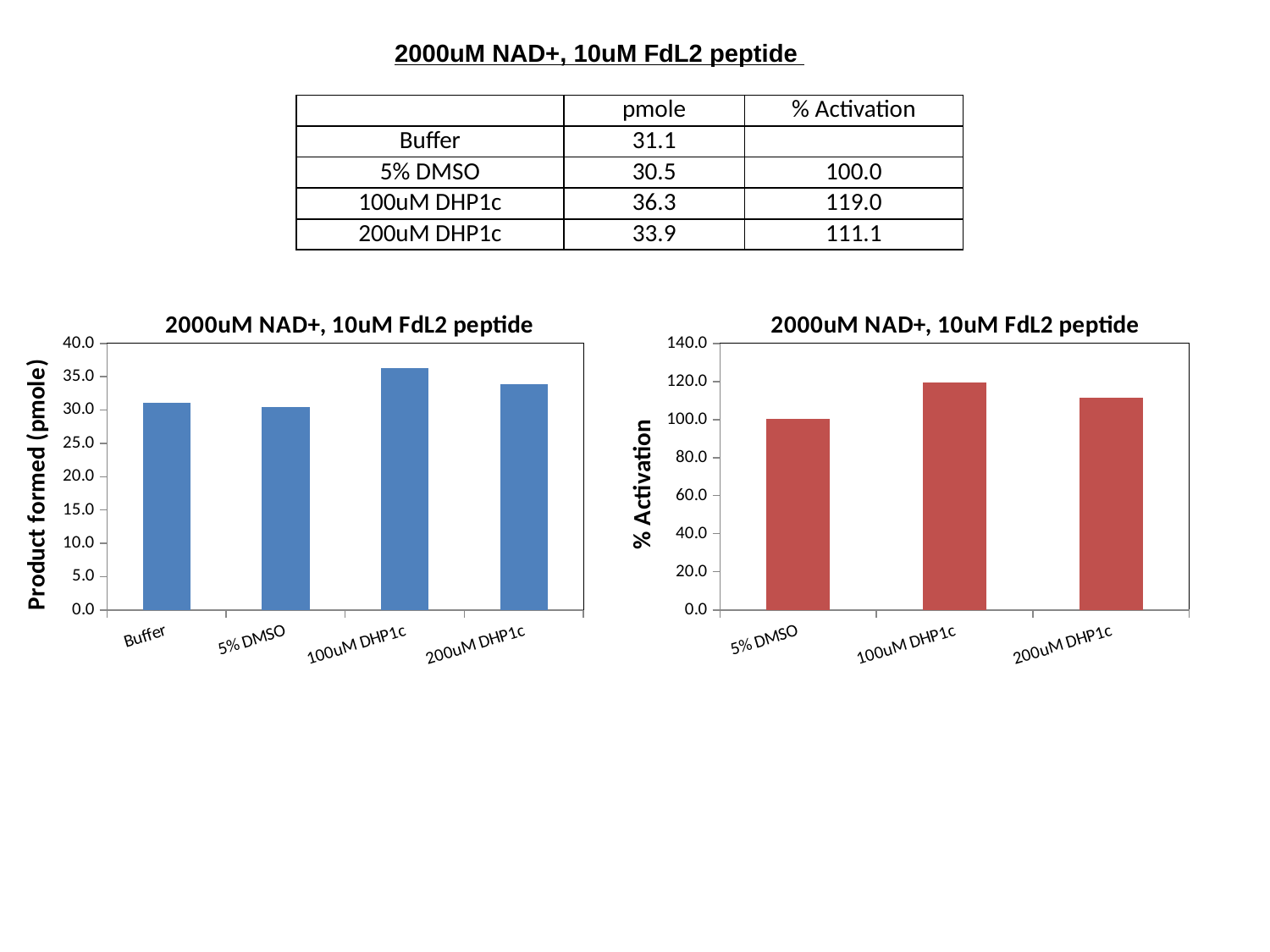
In the left chart (Product formed), is the value for 200uM DHP1c greater or less than 30.0? greater In the right chart (% Activation), what is the value for 200uM DHP1c? 111.1 In the right chart (% Activation), how many bars are plotted? 3 In the right chart (% Activation), is the value for 100uM DHP1c greater or less than 100.0? greater In the left chart (Product formed), what is the value for 100uM DHP1c? 36.3 In the left chart (Product formed), which category has the lowest bar? 5% DMSO In the left chart (Product formed), how many bars are plotted? 4 In the left chart (Product formed), which category has the highest bar? 100uM DHP1c What is the y-axis label of the left chart? Product formed (pmole) In the right chart (% Activation), which category has the highest bar? 100uM DHP1c In the left chart (Product formed), what is the difference between the values for 100uM DHP1c and 5% DMSO? 5.8 What kind of chart is the right chart (% Activation)? bar chart